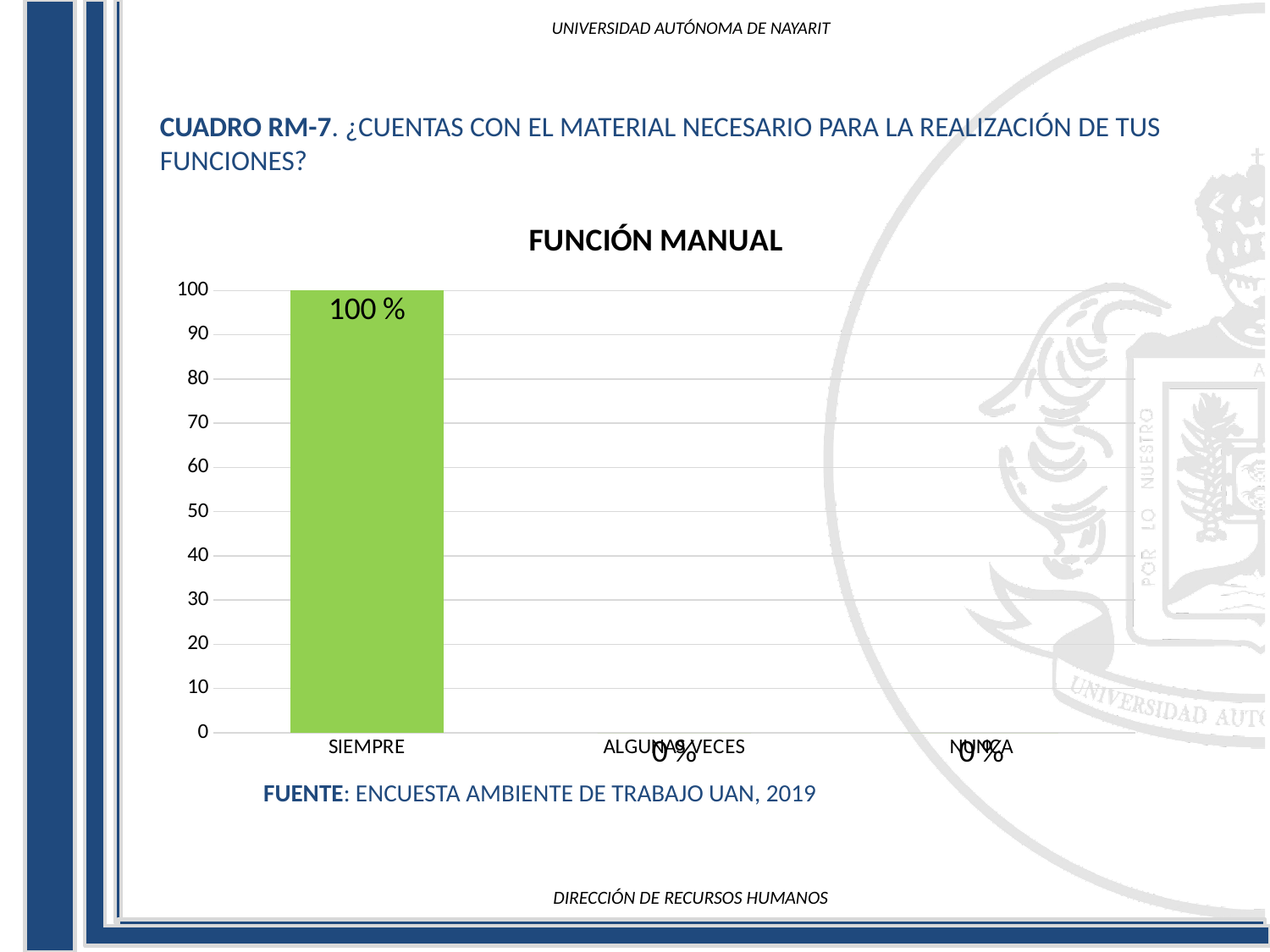
What is the highest value shown on the y axis? 100 Which is larger, the value for SIEMPRE or the value for ALGUNAS VECES? SIEMPRE Which category has the highest value? SIEMPRE What is the value for SIEMPRE? 100 % What is the title of the chart? FUNCIÓN MANUAL What is the value for NUNCA? 0 % What kind of chart is shown? bar chart How many categories are shown on the x axis? 3 Is the value for SIEMPRE greater or less than 50? greater What is the difference between the values for SIEMPRE and NUNCA? 100 % What is the value for ALGUNAS VECES? 0 % What colour is the bar for SIEMPRE? green